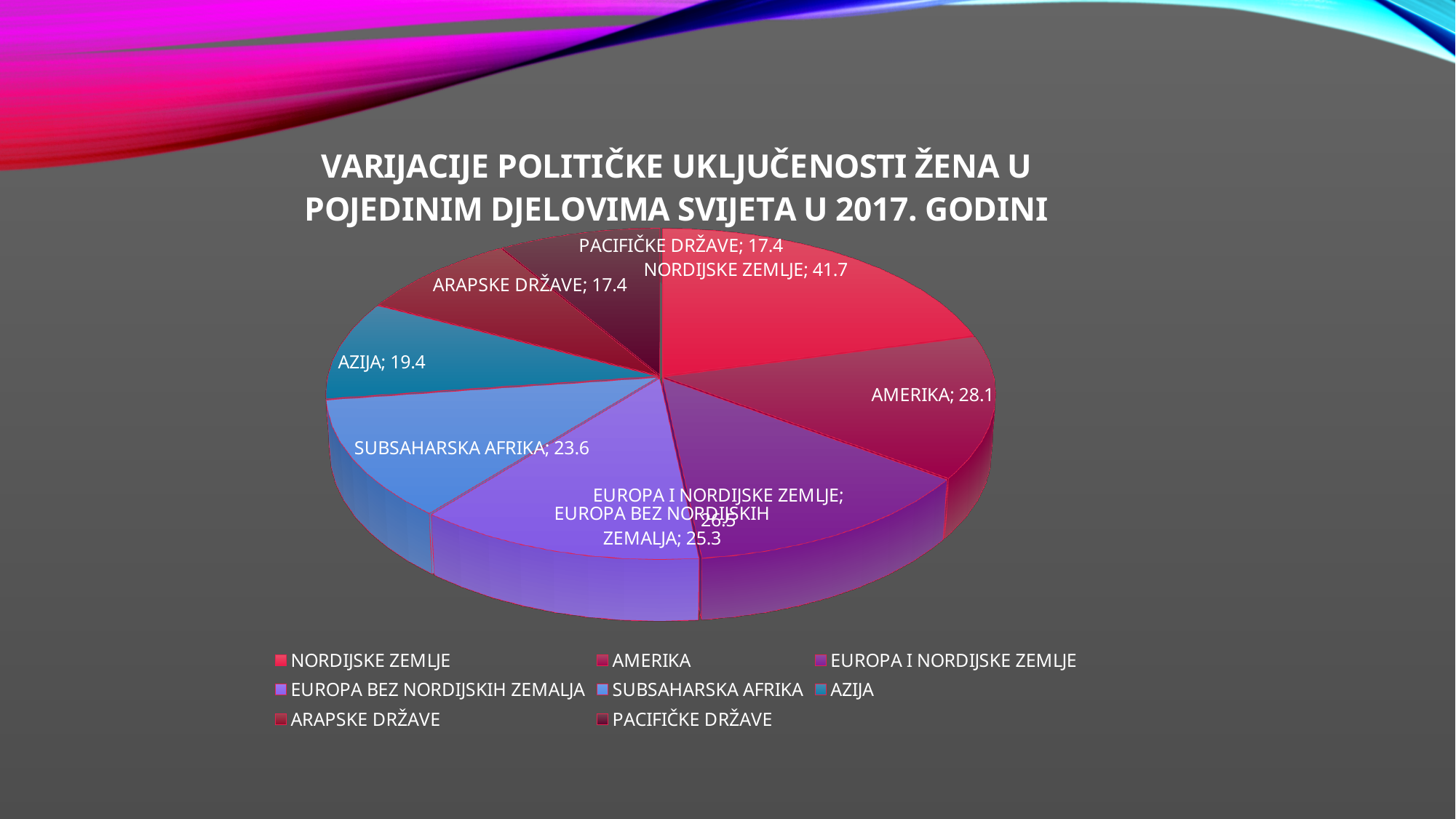
What is the difference between the values for SUBSAHARSKA AFRIKA and AZIJA? 4.2 How many categories does the pie chart have? 8 What is the value for AZIJA? 19.4 What is the difference between the values for NORDIJSKE ZEMLJE and AMERIKA? 13.6 What is the value for EUROPA BEZ NORDIJSKIH ZEMALJA? 25.3 What is the title of the chart? VARIJACIJE POLITIČKE UKLJUČENOSTI ŽENA U POJEDINIM DJELOVIMA SVIJETA U 2017. GODINI What is the value for SUBSAHARSKA AFRIKA? 23.6 What type of chart is shown on the slide? Pie chart Which category has the highest value in the pie chart? NORDIJSKE ZEMLJE What is the value for NORDIJSKE ZEMLJE? 41.7 What is the value for AMERIKA? 28.1 Which is larger, the value for AMERIKA or the value for AZIJA? AMERIKA